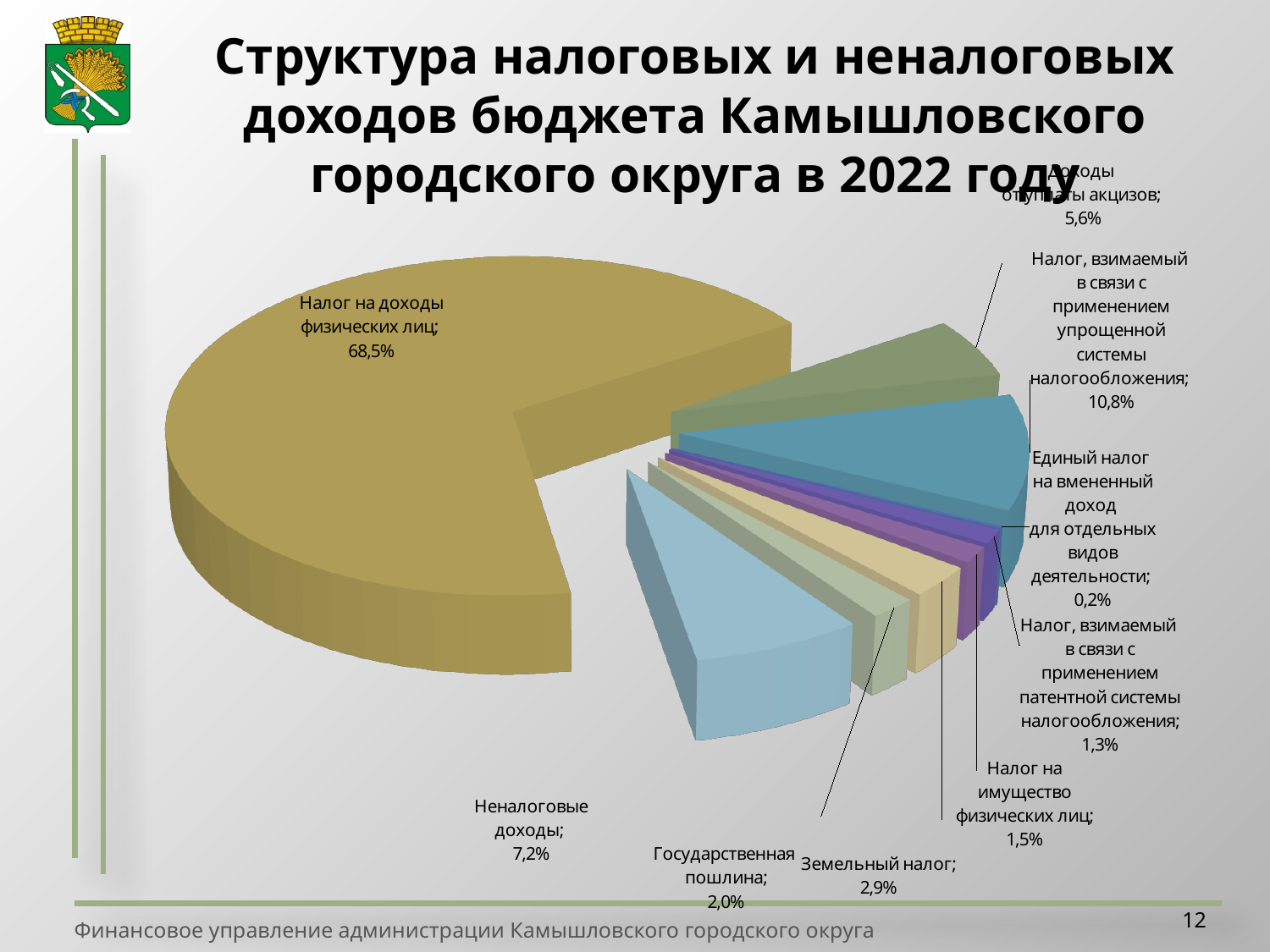
What is the value shown for "Налог, взимаемый в связи с применением упрощенной системы налогообложения"? 10,8% Which category has the largest share of the pie? Налог на доходы физических лиц Which is larger: the share of "Налог на имущество физических лиц" or the share of "Налог, взимаемый в связи с применением патентной системы налогообложения"? Налог на имущество физических лиц What year does the chart title refer to? 2022 What share of the pie is "Налог на доходы физических лиц"? 68,5% How many slices does the pie chart have? 9 What is the value shown for "Земельный налог"? 2,9% What is the value shown for "Государственная пошлина"? 2,0% Which category has the smallest share of the pie? Единый налог на вмененный доход для отдельных видов деятельности What is the difference between the shares of "Неналоговые доходы" and "Доходы от уплаты акцизов"? 1,6% What kind of chart is shown on the slide? Pie chart What is the value shown for "Неналоговые доходы"? 7,2%